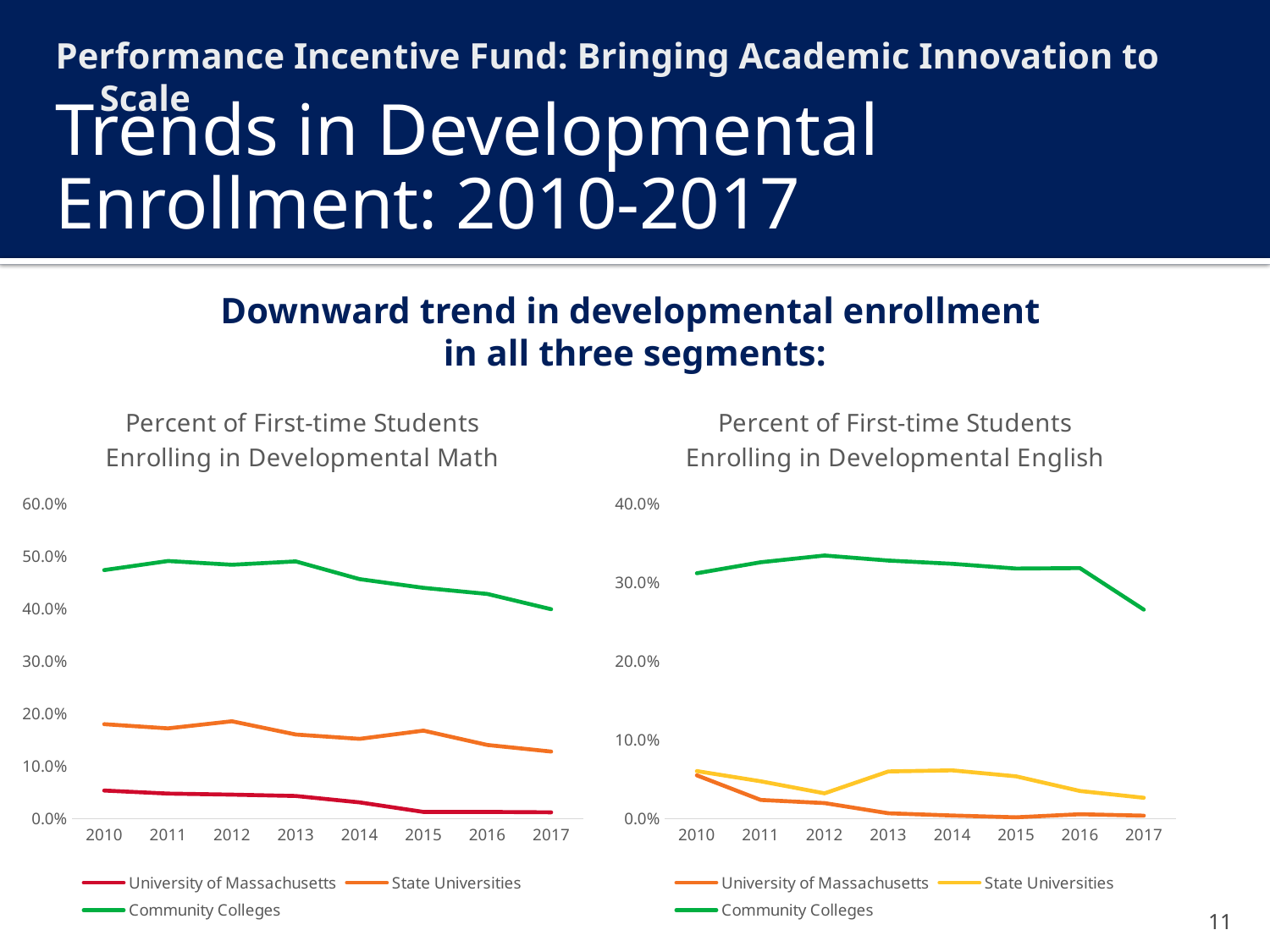
In the 'Percent of First-time Students Enrolling in Developmental Math' chart, do the values for Community Colleges rise or fall from 2013 to 2017? fall In the 'Percent of First-time Students Enrolling in Developmental English' chart, is the value for Community Colleges in 2012 greater or less than 30.0%? greater In the 'Percent of First-time Students Enrolling in Developmental English' chart, is the value for Community Colleges in 2017 greater or less than 30.0%? less What kind of chart is the 'Percent of First-time Students Enrolling in Developmental Math' chart? line chart In the 'Percent of First-time Students Enrolling in Developmental Math' chart, is the value for Community Colleges in 2011 greater or less than 40.0%? greater What kind of chart is the 'Percent of First-time Students Enrolling in Developmental English' chart? line chart How many years are plotted along the x axis of the 'Percent of First-time Students Enrolling in Developmental Math' chart? 8 In the 'Percent of First-time Students Enrolling in Developmental English' chart, which is larger in 2014: State Universities or University of Massachusetts? State Universities In the 'Percent of First-time Students Enrolling in Developmental Math' chart, which series has the highest value in 2017? Community Colleges How many series does the legend of the 'Percent of First-time Students Enrolling in Developmental Math' chart list? 3 In the 'Percent of First-time Students Enrolling in Developmental English' chart, what colour is the Community Colleges line? green